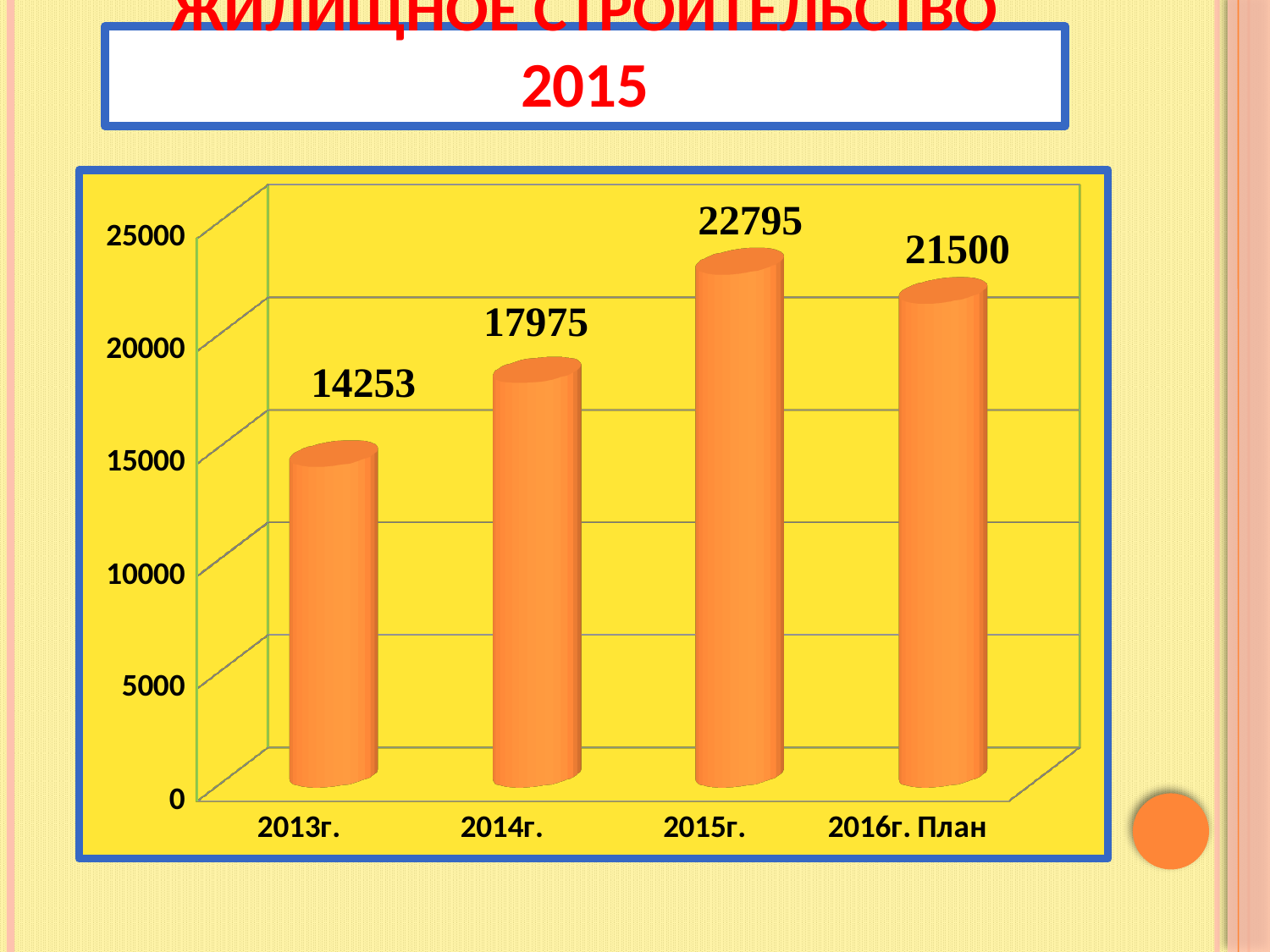
What kind of chart is shown on the slide? bar chart What is the value for 2014г.? 17975 Is the value for 2013г. greater or less than 15000? less Which category has the highest value? 2015г. Which is larger, the value for 2015г. or the value for 2016г. План? 2015г. How many categories are shown on the x axis? 4 What is the difference between the values for 2015г. and 2014г.? 4820 What is the value for 2015г.? 22795 What is the value for 2013г.? 14253 What is the difference between the values for 2014г. and 2013г.? 3722 What is the value for 2016г. План? 21500 Which category has the lowest value? 2013г.